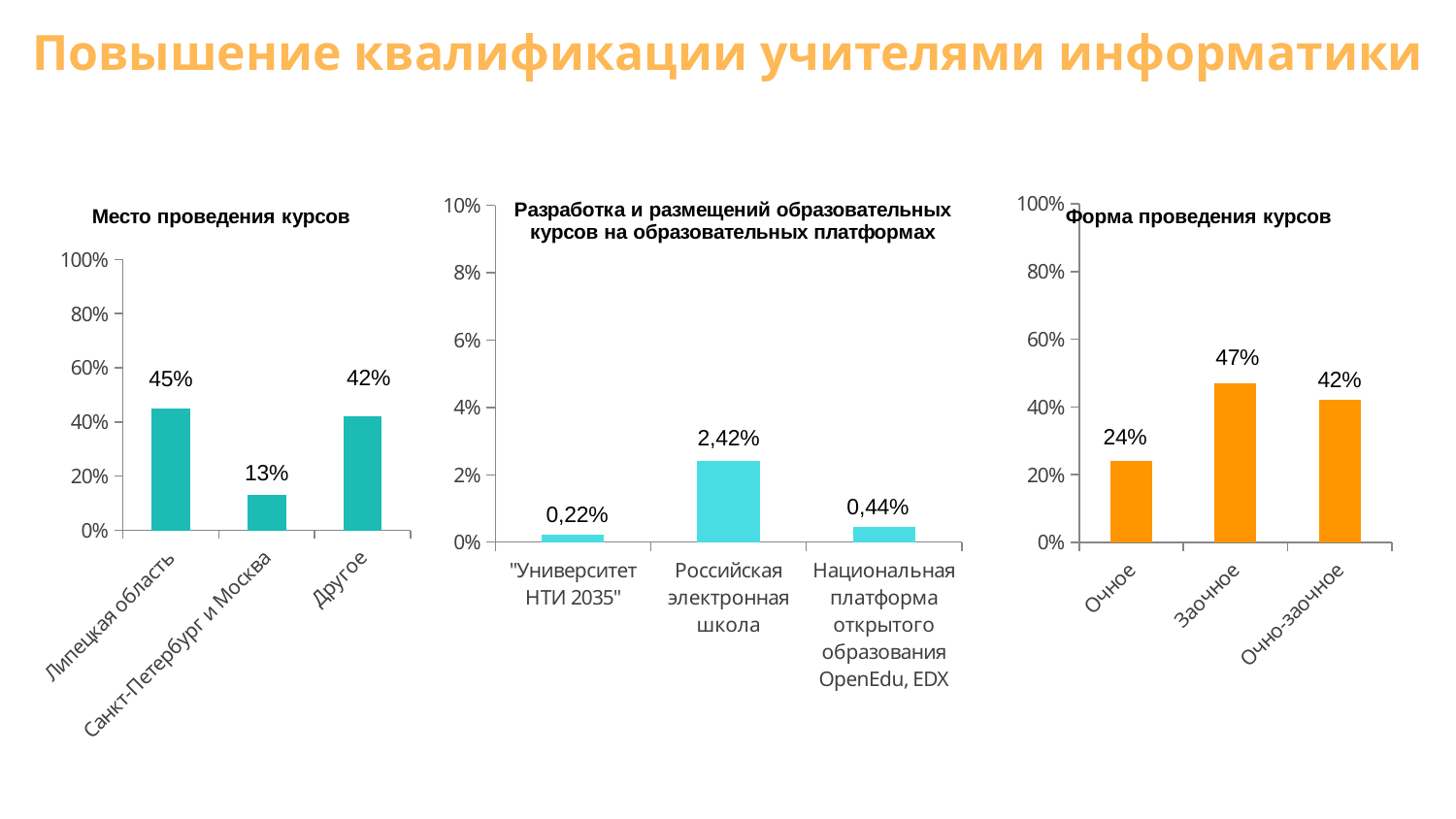
In the chart titled "Разработка и размещений образовательных курсов на образовательных платформах", what is the value for Российская электронная школа? 2,42% In the chart titled "Форма проведения курсов", which is larger: the value for Заочное or Очно-заочное? Заочное In the chart titled "Место проведения курсов", which category has the lowest value? Санкт-Петербург и Москва In the chart titled "Форма проведения курсов", what is the difference between the values for Заочное and Очное? 23% In the chart titled "Форма проведения курсов", what is the value for Заочное? 47% In the chart titled "Разработка и размещений образовательных курсов на образовательных платформах", how many categories are shown? 3 In the chart titled "Форма проведения курсов", which category has the lowest value? Очное What kind of chart is the chart titled "Форма проведения курсов"? Bar chart In the chart titled "Разработка и размещений образовательных курсов на образовательных платформах", which category has the highest value? Российская электронная школа In the chart titled "Место проведения курсов", what is the value for Липецкая область? 45% In the chart titled "Место проведения курсов", what is the difference between the values for Липецкая область and Другое? 3% In the chart titled "Разработка и размещений образовательных курсов на образовательных платформах", what is the value for "Университет НТИ 2035"? 0,22%